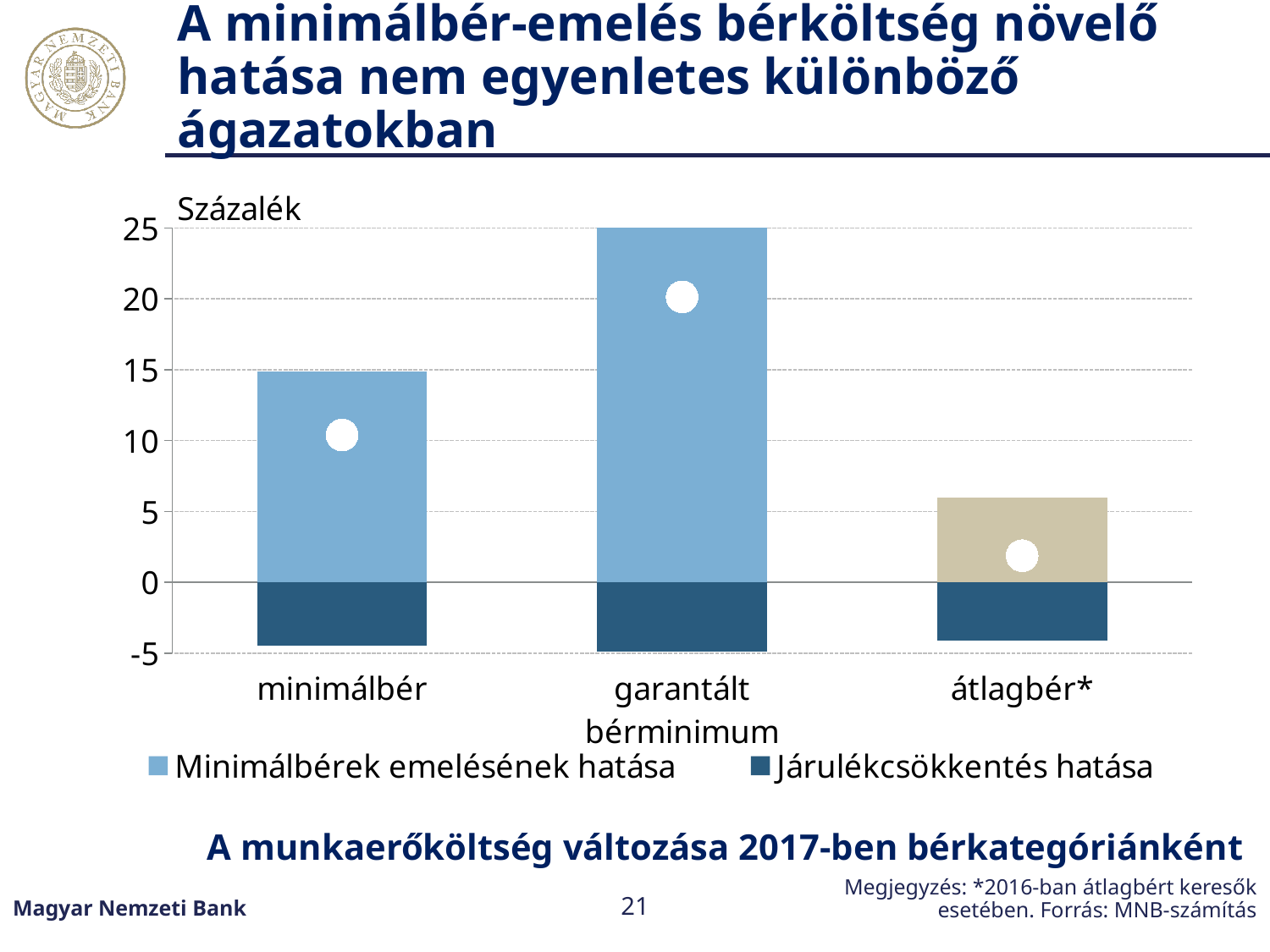
Is the Járulékcsökkentés hatása value for minimálbér greater or less than 0? less What unit label is shown at the top of the vertical axis? Százalék Which category has the lowest value for Minimálbérek emelésének hatása? átlagbér* Is the Minimálbérek emelésének hatása value for átlagbér* greater or less than 10? less Which has the larger Minimálbérek emelésének hatása value, minimálbér or átlagbér*? minimálbér How many series does the chart legend list? 2 What kind of chart is shown on the slide? bar chart Which category has the highest value for Minimálbérek emelésének hatása? garantált bérminimum Which legend entry is shown in dark blue? Járulékcsökkentés hatása How many categories are shown on the x axis of the chart? 3